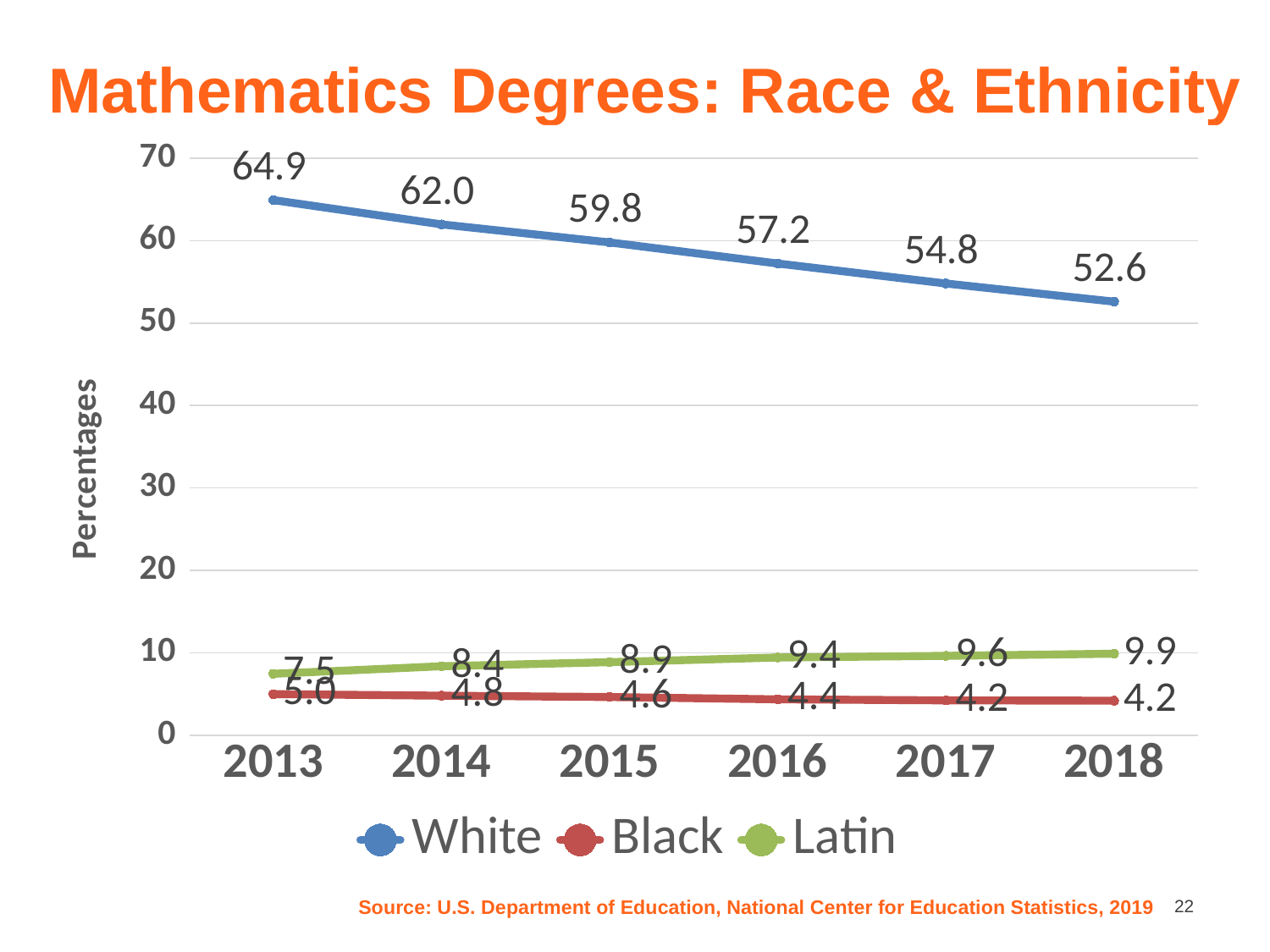
What is the value for Latin in 2018? 9.9 What is the value for White in 2013? 64.9 In which year is the Latin series at its highest? 2018 Is the value for White in 2017 greater or less than 50? greater In which year is the White series at its lowest? 2018 How many series does the legend list? 3 Does the White series rise or fall from 2013 to 2018? fall What kind of chart is shown on the slide? line chart What is the difference between the White values in 2013 and 2018? 12.3 How many years are shown on the x axis? 6 Which is larger in 2016, the Latin value or the Black value? Latin What is the value for Black in 2015? 4.6